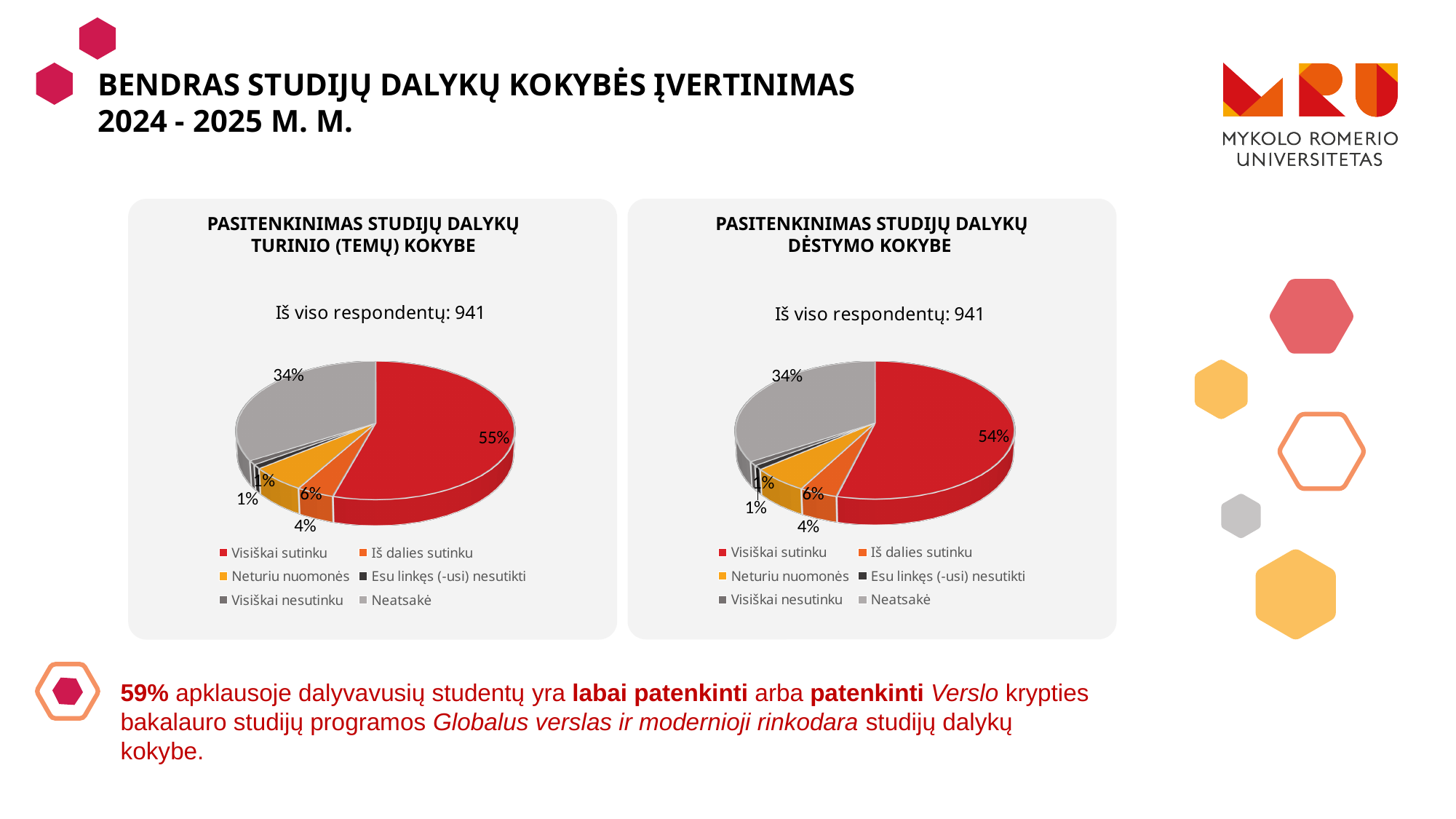
In the left chart (Pasitenkinimas studijų dalykų turinio (temų) kokybe), which category has the largest slice? Visiškai sutinku In the left chart (Pasitenkinimas studijų dalykų turinio (temų) kokybe), what is the difference between the 'Visiškai sutinku' share and the 'Neatsakė' share? 21% In the right chart (Pasitenkinimas studijų dalykų dėstymo kokybe), what share of respondents answered 'Visiškai sutinku'? 54% In the left chart (Pasitenkinimas studijų dalykų turinio (temų) kokybe), what share is labelled for 'Neatsakė'? 34% In the left chart (Pasitenkinimas studijų dalykų turinio (temų) kokybe), what share of respondents answered 'Visiškai sutinku'? 55% What type of chart is used in the right chart (Pasitenkinimas studijų dalykų dėstymo kokybe)? Pie chart In the right chart (Pasitenkinimas studijų dalykų dėstymo kokybe), what is the difference between the 'Visiškai sutinku' share and the 'Neatsakė' share? 20% How many respondents in total are reported for the left chart (Pasitenkinimas studijų dalykų turinio (temų) kokybe)? 941 How many categories does the legend of the left chart (Pasitenkinimas studijų dalykų turinio (temų) kokybe) list? 6 In the right chart (Pasitenkinimas studijų dalykų dėstymo kokybe), which category has the largest slice? Visiškai sutinku Which chart has the larger 'Visiškai sutinku' share, the left one (turinio (temų) kokybe) or the right one (dėstymo kokybe)? The left one (turinio (temų) kokybe) In the right chart (Pasitenkinimas studijų dalykų dėstymo kokybe), what share is labelled for 'Neturiu nuomonės'? 6%